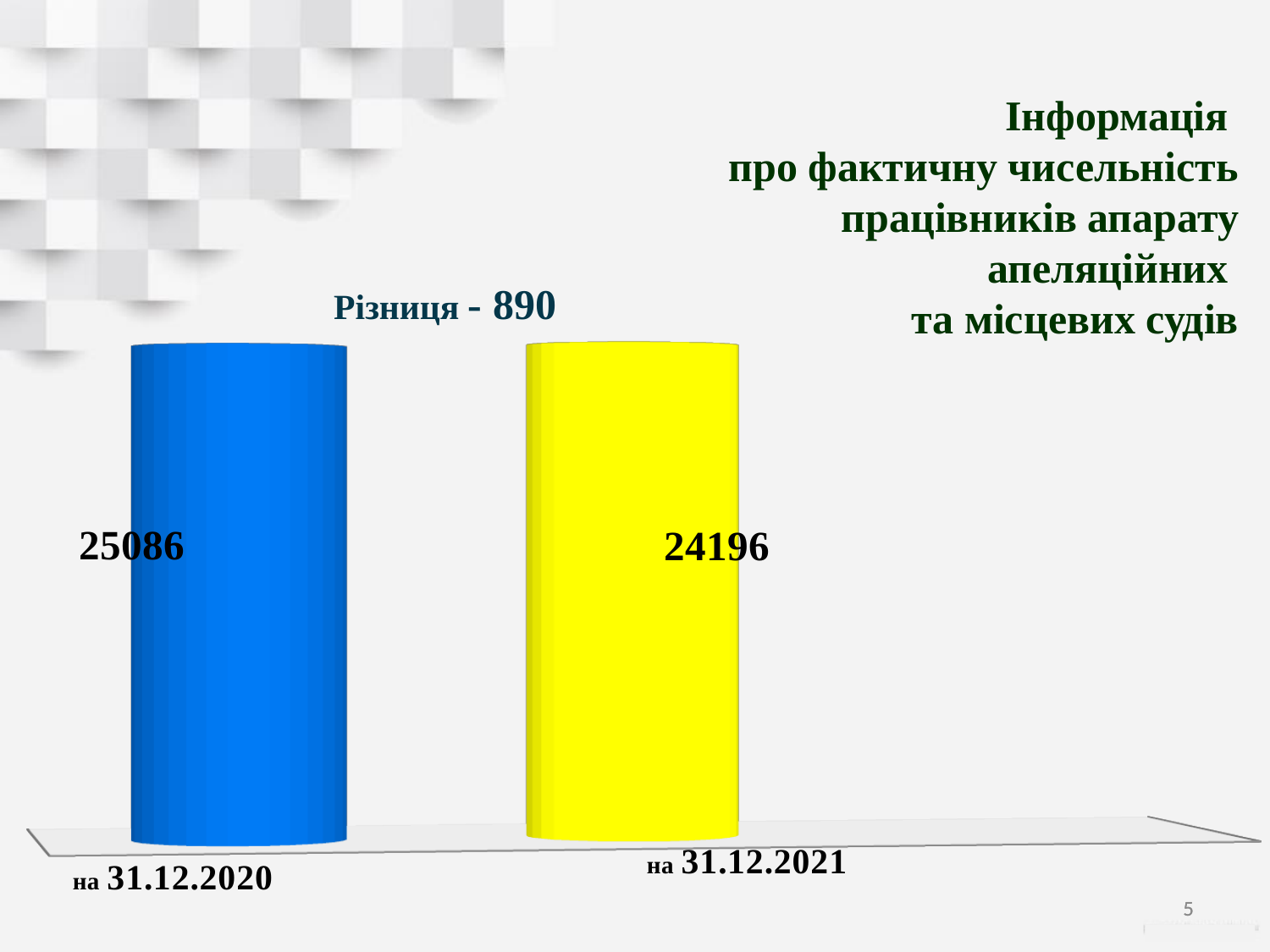
What kind of chart is shown on the slide? bar chart Which category has the lowest value? на 31.12.2021 What colour is the bar for на 31.12.2021? yellow What is the value for на 31.12.2021? 24196 Do the values rise or fall from на 31.12.2020 to на 31.12.2021? fall What difference is stated in the text above the chart (Різниця)? 890 How many categories are shown in the chart? 2 Which category has the higher value, на 31.12.2020 or на 31.12.2021? на 31.12.2020 What is the value for на 31.12.2020? 25086 Which category has the highest value? на 31.12.2020 What is the difference between the values for на 31.12.2020 and на 31.12.2021? 890